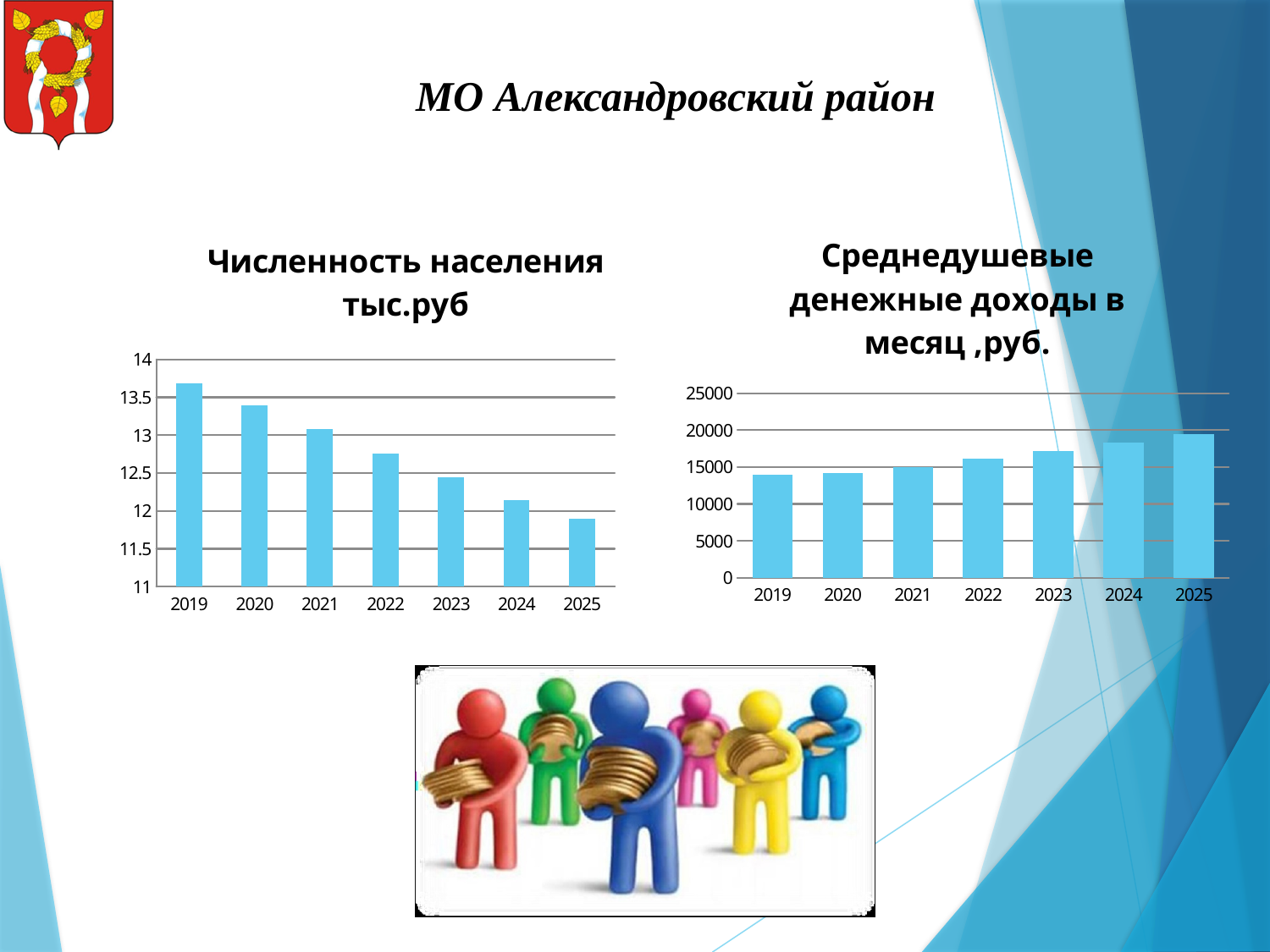
In the 'Численность населения тыс.руб' chart, which year has the highest value? 2019 In the 'Численность населения тыс.руб' chart, which year has the lowest value? 2025 What kind of chart is the 'Численность населения тыс.руб' chart? bar chart How many years are shown on the x axis of the 'Численность населения тыс.руб' chart? 7 In the 'Среднедушевые денежные доходы в месяц ,руб.' chart, which year has the highest value? 2025 In the 'Среднедушевые денежные доходы в месяц ,руб.' chart, which is larger, the value for 2023 or the value for 2020? 2023 In the 'Численность населения тыс.руб' chart, is the value for 2025 greater or less than 12? less In the 'Численность населения тыс.руб' chart, do the values rise or fall from 2019 to 2025? fall In the 'Среднедушевые денежные доходы в месяц ,руб.' chart, is the value for 2019 greater or less than 15000? less In the 'Численность населения тыс.руб' chart, is the value for 2019 greater or less than 13.5? greater In the 'Среднедушевые денежные доходы в месяц ,руб.' chart, do the values rise or fall from 2019 to 2025? rise